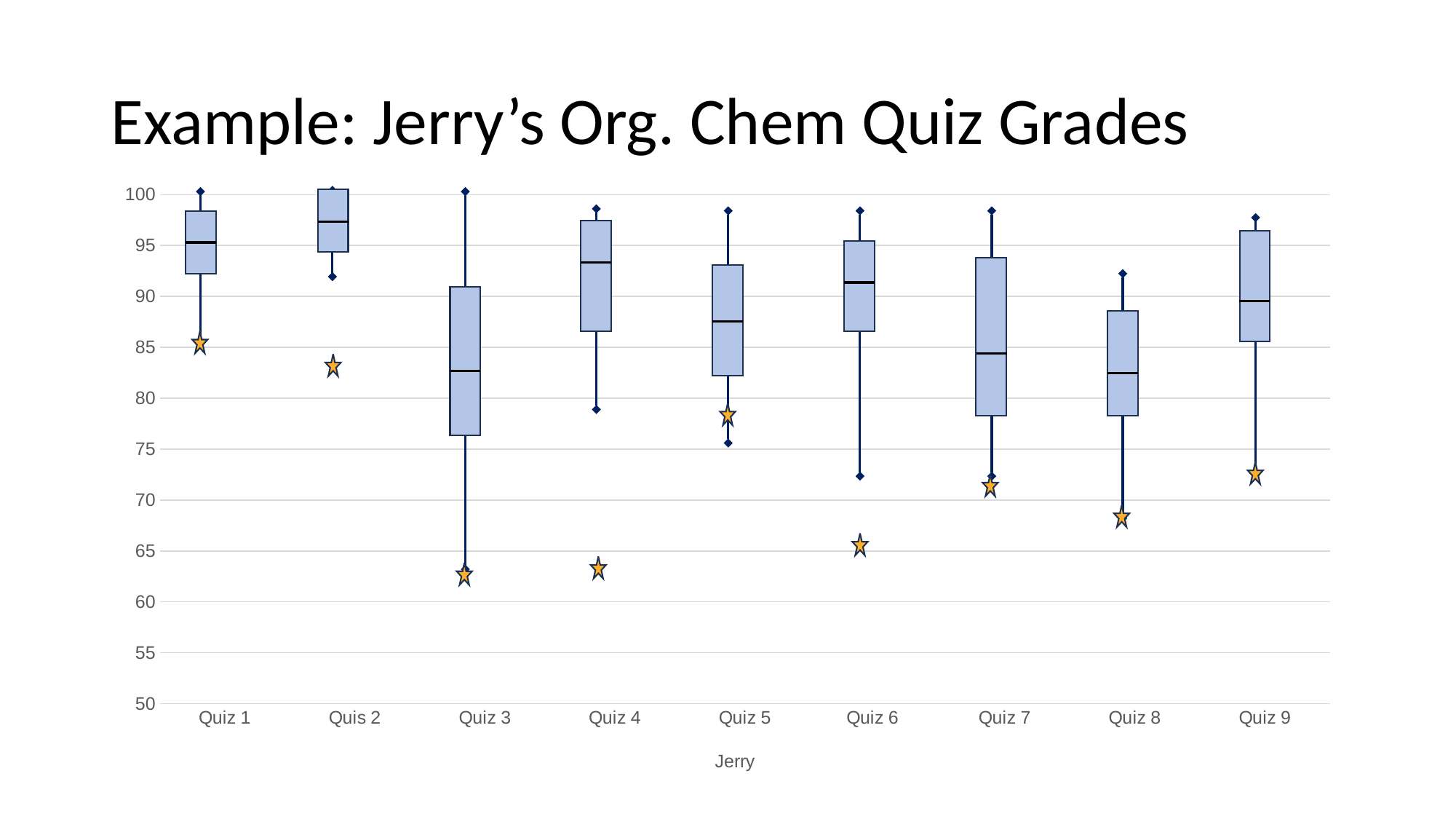
How many quizzes are shown along the x axis of the chart? 9 What label is printed below the x axis of the chart? Jerry Which quiz has the highest median (the black line inside the box)? Quis 2 Is Jerry's grade (the star marker) higher for Quiz 1 or for Quiz 3? Quiz 1 Is Jerry's grade (the star marker) for Quiz 1 greater or less than 80? greater Is Jerry's grade (the star marker) for Quiz 8 greater or less than 70? less What kind of chart is shown on the slide? box-and-whisker plot Is Jerry's grade (the star marker) for Quiz 5 greater or less than 80? less Is the median (black line inside the box) higher for Quis 2 or for Quiz 7? Quis 2